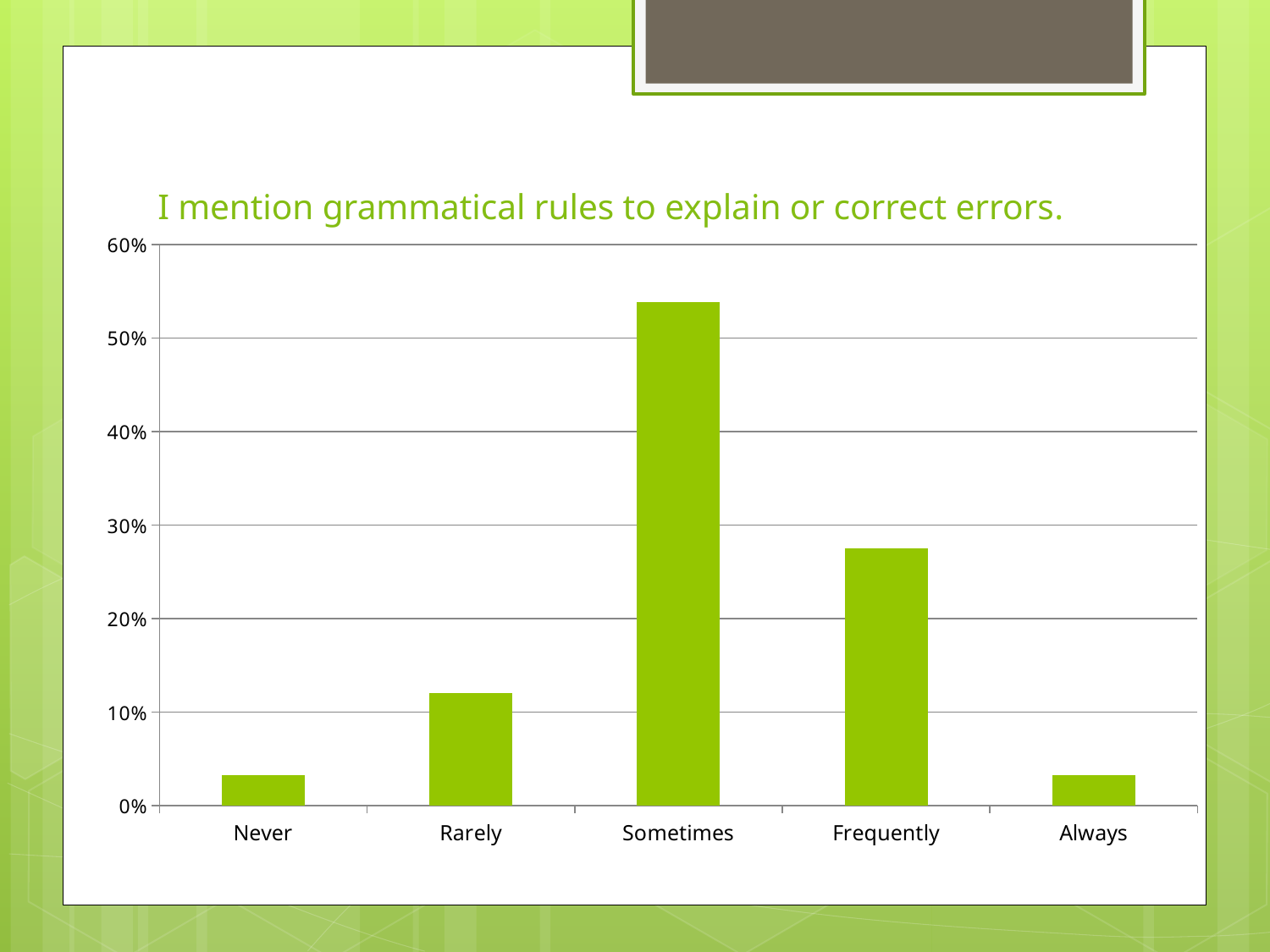
Do the values rise or fall from Sometimes to Always along the x axis? fall Which category has the highest value? Sometimes What kind of chart is shown on the slide? bar chart How many categories are shown on the x axis? 5 What is the title of the chart? I mention grammatical rules to explain or correct errors. Is the value for Frequently greater or less than 30%? less Which is larger, the value for Sometimes or the value for Frequently? Sometimes Is the value for Always greater or less than 10%? less Is the value for Never greater or less than 10%? less Which is larger, the value for Rarely or the value for Never? Rarely